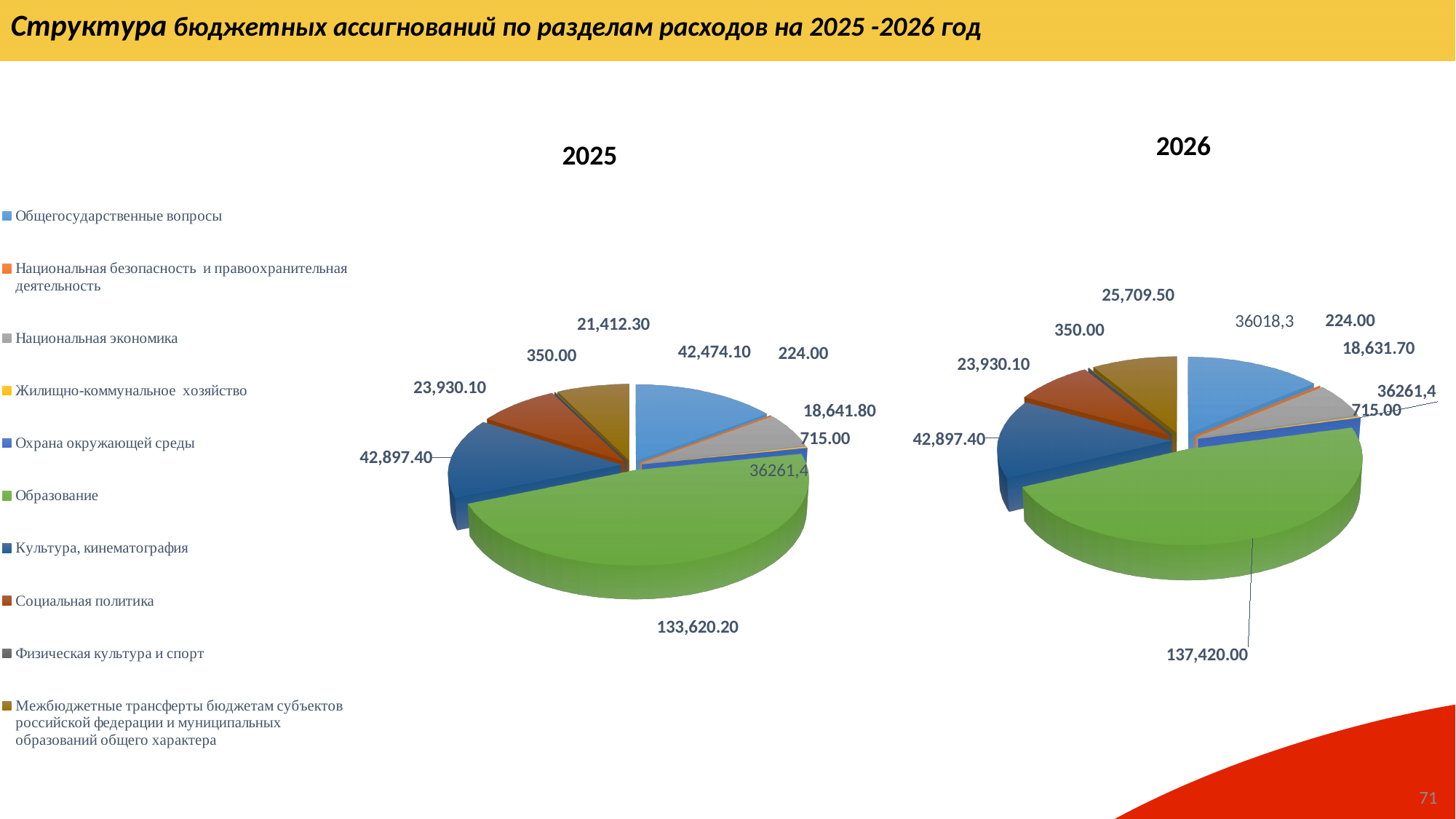
In the 2025 chart, which category has the largest slice? Образование In the 2026 chart, what is the value for Образование? 137,420.00 What is the difference between the Межбюджетные трансферты value in the 2026 chart (25,709.50) and in the 2025 chart (21,412.30)? 4,297.20 How many categories does the legend list? 10 In the 2025 chart, what is the value for Образование? 133,620.20 In the 2026 chart, which category has the largest slice? Образование What is the difference between the Образование value in the 2026 chart and in the 2025 chart? 3,799.80 In the 2026 chart, which is larger: the slice for Образование or the slice for Культура, кинематография? Образование What kind of chart is used for the 2025 data on the slide? pie chart In the 2025 chart, what is the value for Общегосударственные вопросы? 42,474.10 In the 2026 chart, what is the value for Социальная политика? 23,930.10 In the 2025 chart, what is the value for Культура, кинематография? 42,897.40